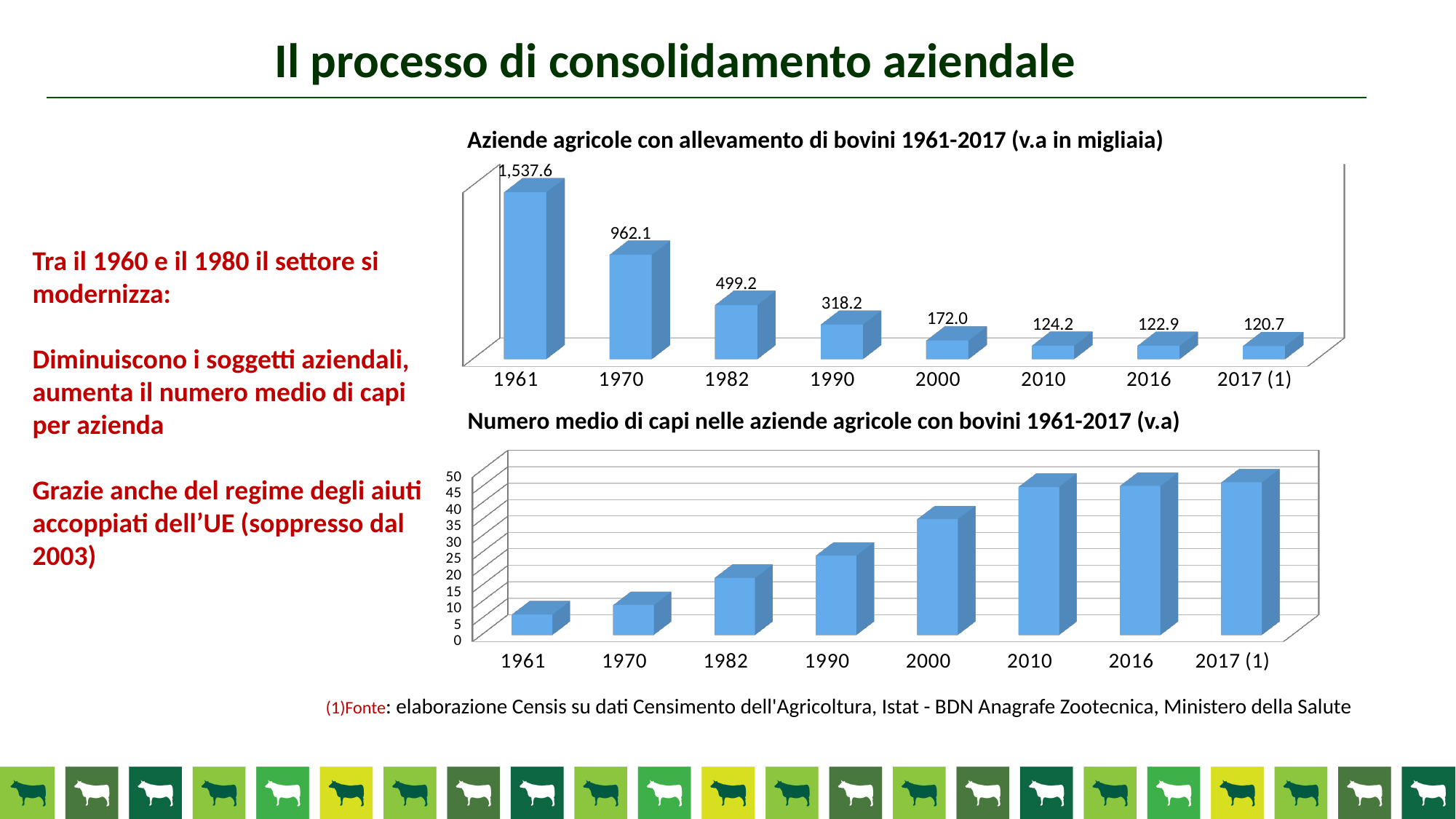
In the bottom chart (Numero medio di capi), which year has the lowest value? 1961 What type of chart is the bottom chart (Numero medio di capi)? bar chart In the top chart (Aziende agricole con allevamento di bovini), what is the value for 2000? 172.0 In the bottom chart (Numero medio di capi), is the value for 1961 greater or less than 10? less In the bottom chart (Numero medio di capi), do the values rise or fall from 1961 to 2017? rise In the top chart (Aziende agricole con allevamento di bovini), how many years are shown on the x axis? 8 In the bottom chart (Numero medio di capi), is the value for 2010 greater or less than 40? greater In the top chart (Aziende agricole con allevamento di bovini), do the values rise or fall from 1961 to 2017? fall In the top chart (Aziende agricole con allevamento di bovini), what is the value for 1961? 1,537.6 In the top chart (Aziende agricole con allevamento di bovini), which year has the lowest value? 2017 (1) In the top chart (Aziende agricole con allevamento di bovini), what is the difference between the values for 1970 and 1982? 462.9 In the top chart (Aziende agricole con allevamento di bovini), which year has the highest value? 1961